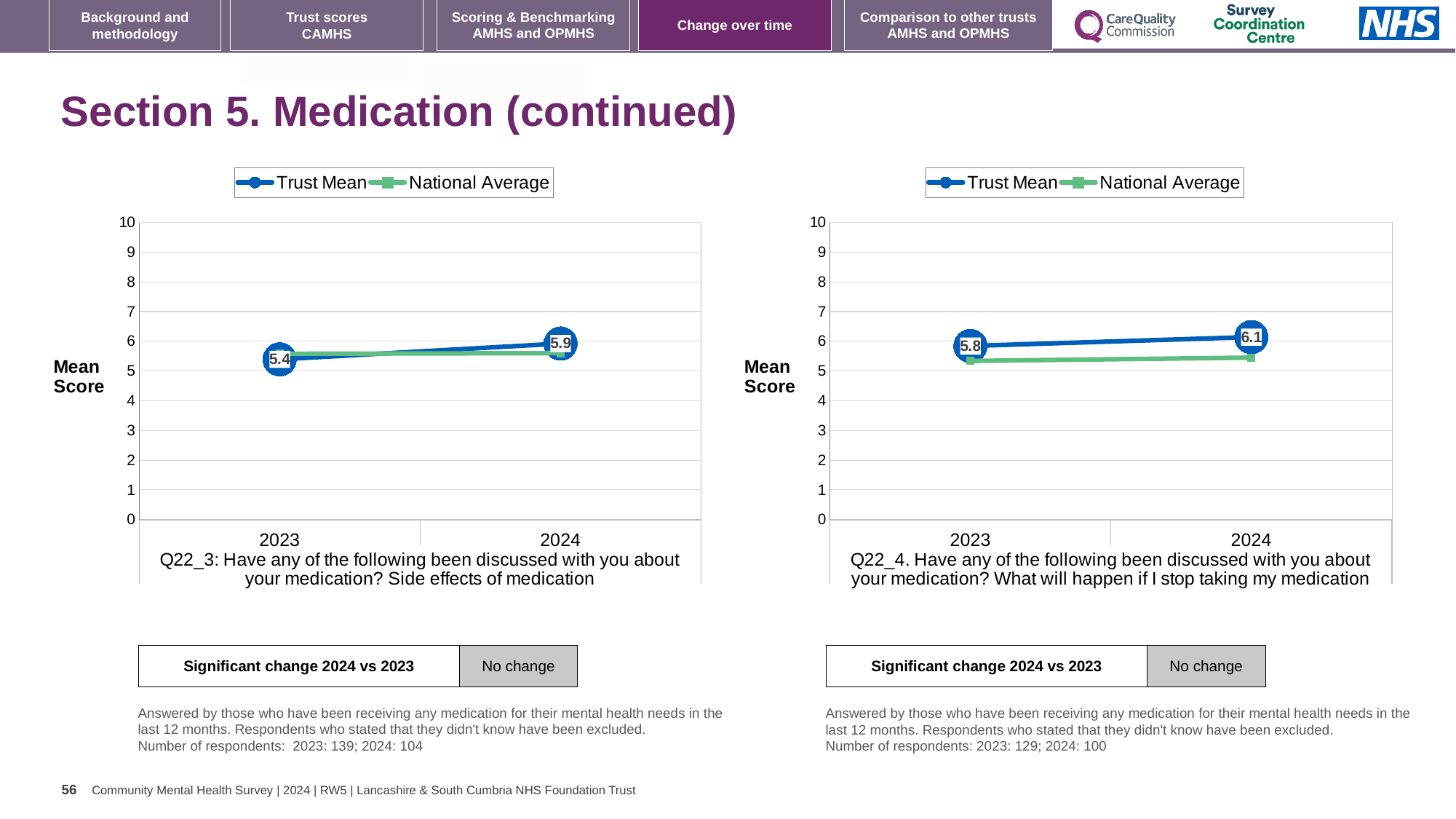
In the Q22_4 chart (right), what is the Trust Mean score for 2023? 5.8 In the Q22_4 chart (right), is the National Average for 2024 greater or less than 6? less In the Q22_3 chart (left), what is the Trust Mean score for 2023? 5.4 What type of chart is the Q22_3 chart (left)? line chart In the Q22_4 chart (right), by how much did the Trust Mean change from 2023 to 2024? 0.3 How many years are shown on the x axis of the Q22_3 chart (left)? 2 In the Q22_4 chart (right), what is the Trust Mean score for 2024? 6.1 In the Q22_4 chart (right), which is larger in 2024, the Trust Mean or the National Average? Trust Mean In the Q22_4 chart (right), does the Trust Mean rise or fall from 2023 to 2024? rise How many series does the legend of the Q22_4 chart (right) list? 2 In the Q22_3 chart (left), what is the Trust Mean score for 2024? 5.9 In the Q22_3 chart (left), by how much did the Trust Mean change from 2023 to 2024? 0.5